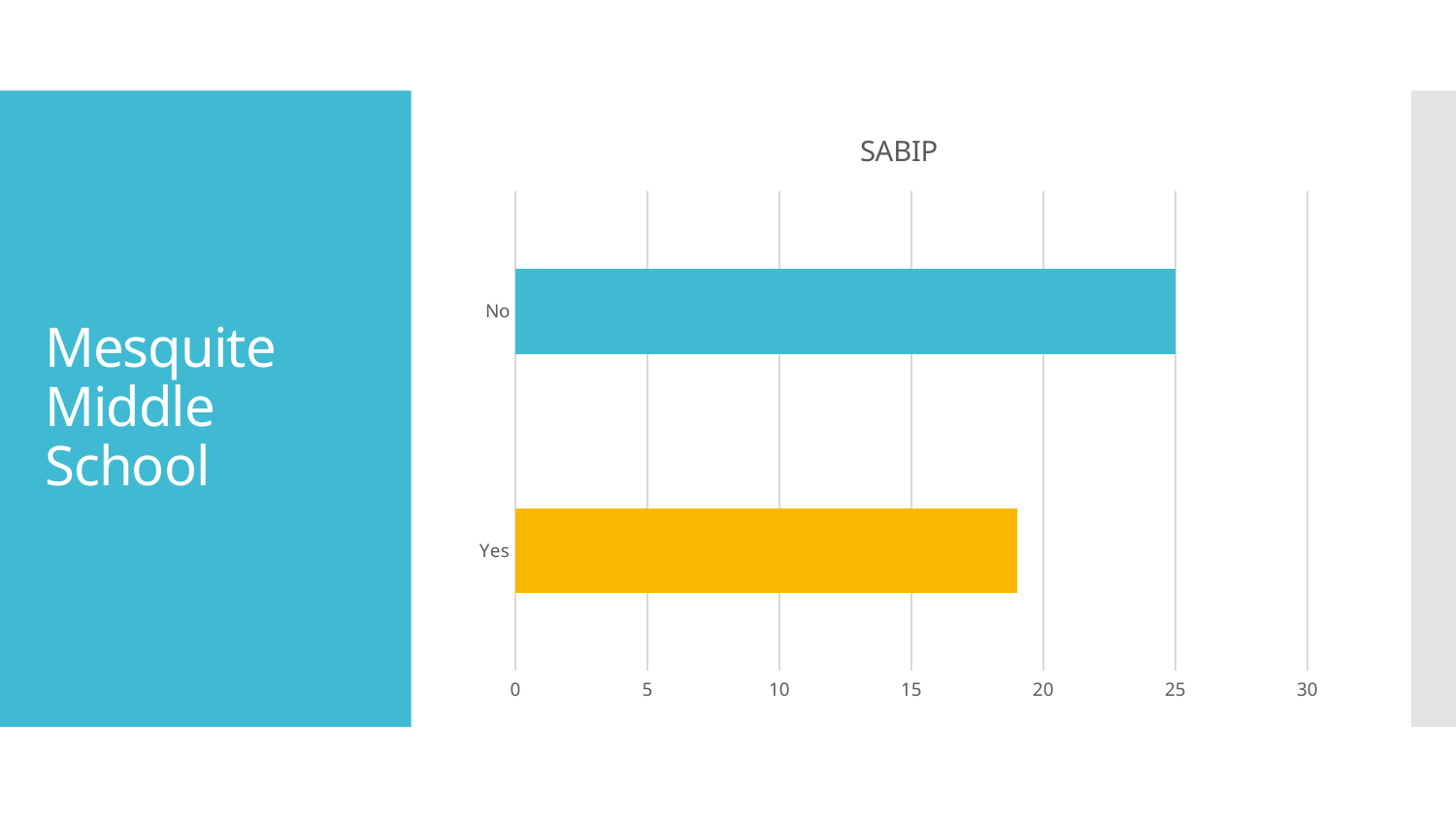
What is the highest value shown on the horizontal axis of the SABIP chart? 30 What is the value for No in the SABIP chart? 25 Is the value for No greater or less than 20? greater Which category has the highest value in the SABIP chart? No Is the value for Yes greater or less than 20? less How many categories are shown in the SABIP chart? 2 What type of chart is shown on the slide? bar chart What colour is the bar for Yes in the SABIP chart? yellow Is the value for Yes greater or less than 15? greater Which is larger in the SABIP chart, the value for No or the value for Yes? No Which category has the lowest value in the SABIP chart? Yes What is the title of the chart? SABIP